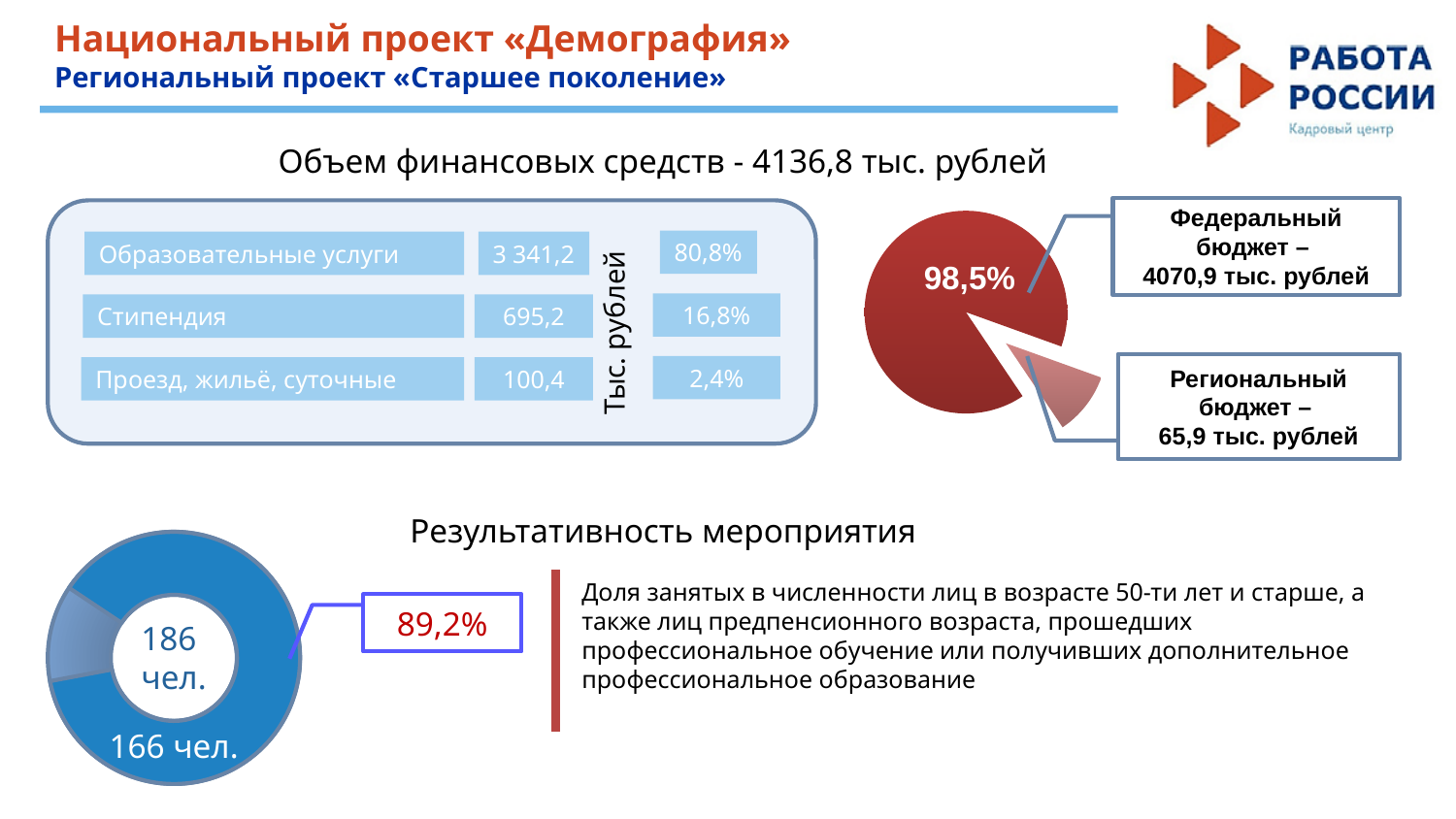
In the pie chart on the right, what percentage is shown for the federal budget slice? 98,5% In the pie chart on the right, what is the value of the federal budget (Федеральный бюджет)? 4070,9 тыс. рублей In the donut chart at the bottom left, what percentage is shown in the callout box? 89,2% In the donut chart at the bottom left, what value is labelled on the large blue segment? 166 чел. In the pie chart on the right, how many slices are there? 2 In the pie chart on the right, which slice is larger: the federal budget or the regional budget? Федеральный бюджет In the pie chart on the right, what is the value of the regional budget (Региональный бюджет)? 65,9 тыс. рублей In the donut chart at the bottom left, what value is shown in the centre? 186 чел. In the pie chart on the right, what is the total of the federal and regional budgets? 4136,8 тыс. рублей What kind of chart is shown in the bottom left of the slide? Donut (pie) chart In the pie chart on the right, what is the difference between the federal budget and the regional budget? 4005,0 тыс. рублей What kind of chart is shown in the top right of the slide? Pie chart